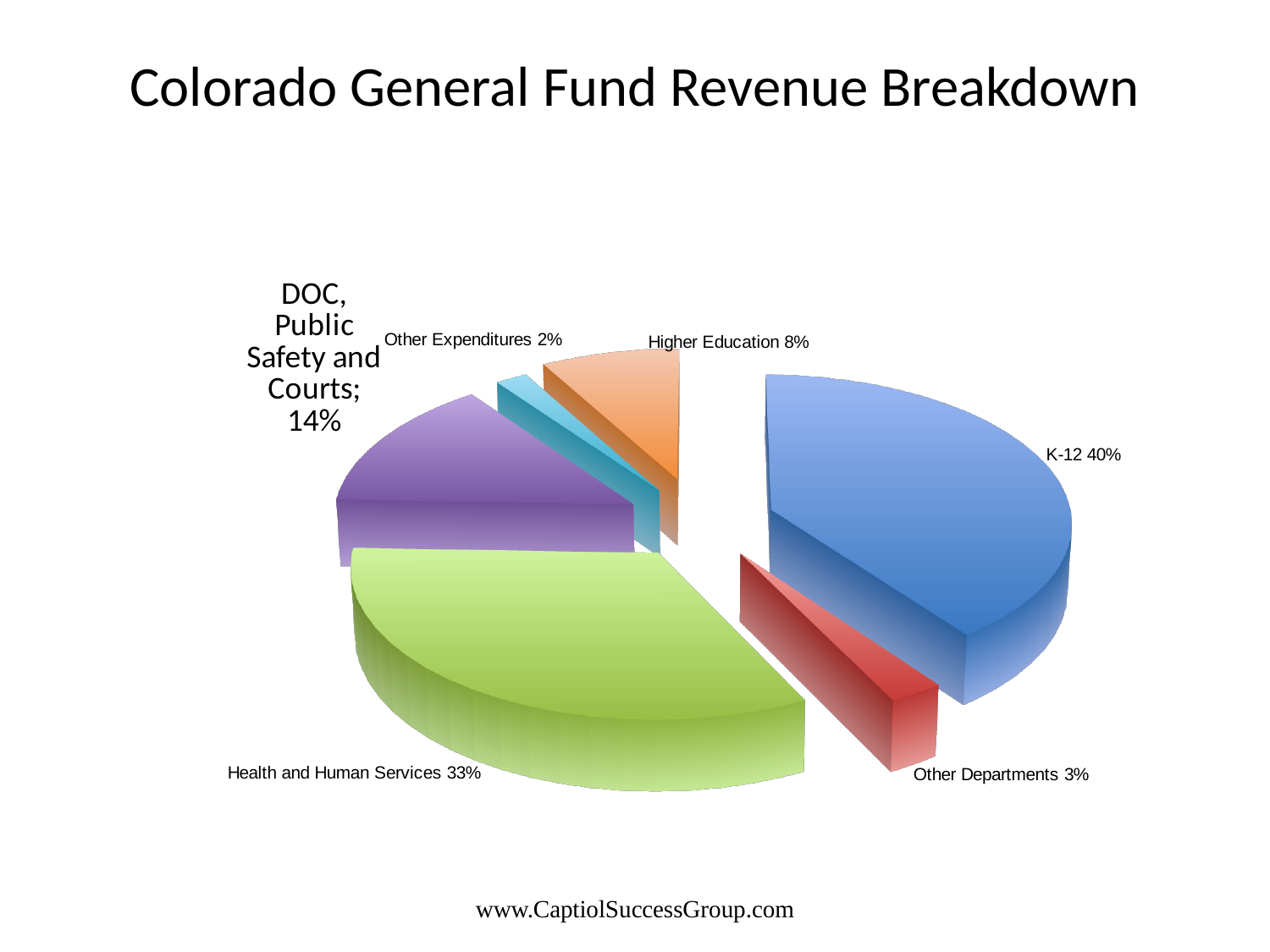
What share of the pie does Other Departments represent? 3% What kind of chart is shown on the slide? Pie chart How many slices does the pie chart have? 6 What share of the pie does Higher Education represent? 8% What share of the pie does Health and Human Services represent? 33% Which category has the smallest share of the pie? Other Expenditures Which is larger, the share for Higher Education or the share for DOC, Public Safety and Courts? DOC, Public Safety and Courts Which category has the largest share of the pie? K-12 What share of the pie does DOC, Public Safety and Courts represent? 14% What is the difference in percentage points between K-12 and Health and Human Services? 7 What is the title of the chart? Colorado General Fund Revenue Breakdown What share of the pie does K-12 represent? 40%